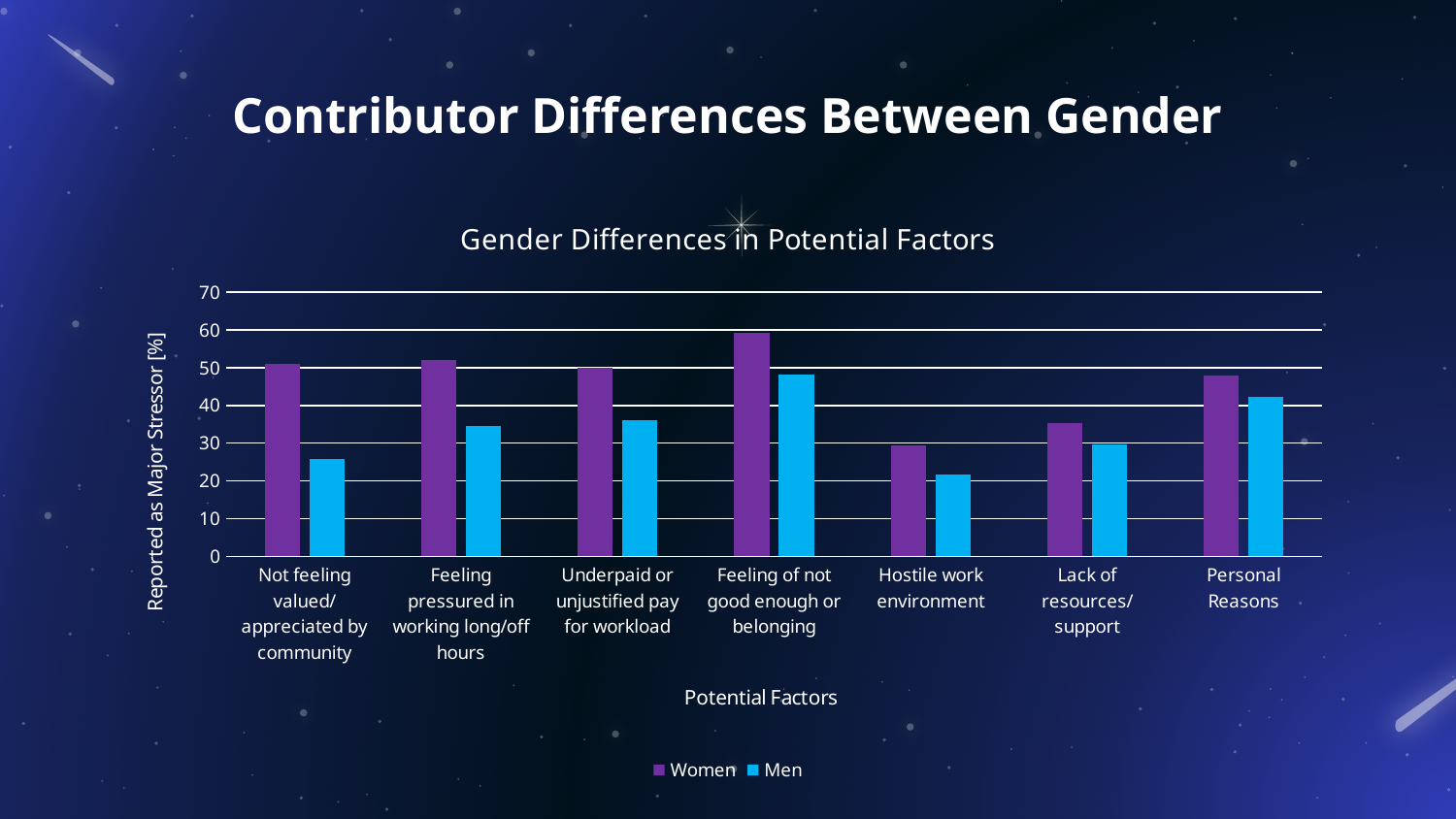
For which potential factor is the Women value highest? Feeling of not good enough or belonging How many potential factors (categories) are shown on the x axis? 7 Is the Men value for Not feeling valued/appreciated by community greater or less than 30? less How many series does the legend list? 2 What kind of chart is shown on the slide? Bar chart For which potential factor is the Men value highest? Feeling of not good enough or belonging What is the title of the chart? Gender Differences in Potential Factors For which potential factor is the Women value lowest? Hostile work environment Is the Women value for Feeling of not good enough or belonging greater or less than 50? greater What is the label of the vertical axis? Reported as Major Stressor [%] Is the Men value for Hostile work environment greater or less than 30? less For Underpaid or unjustified pay for workload, which series has the larger value, Women or Men? Women